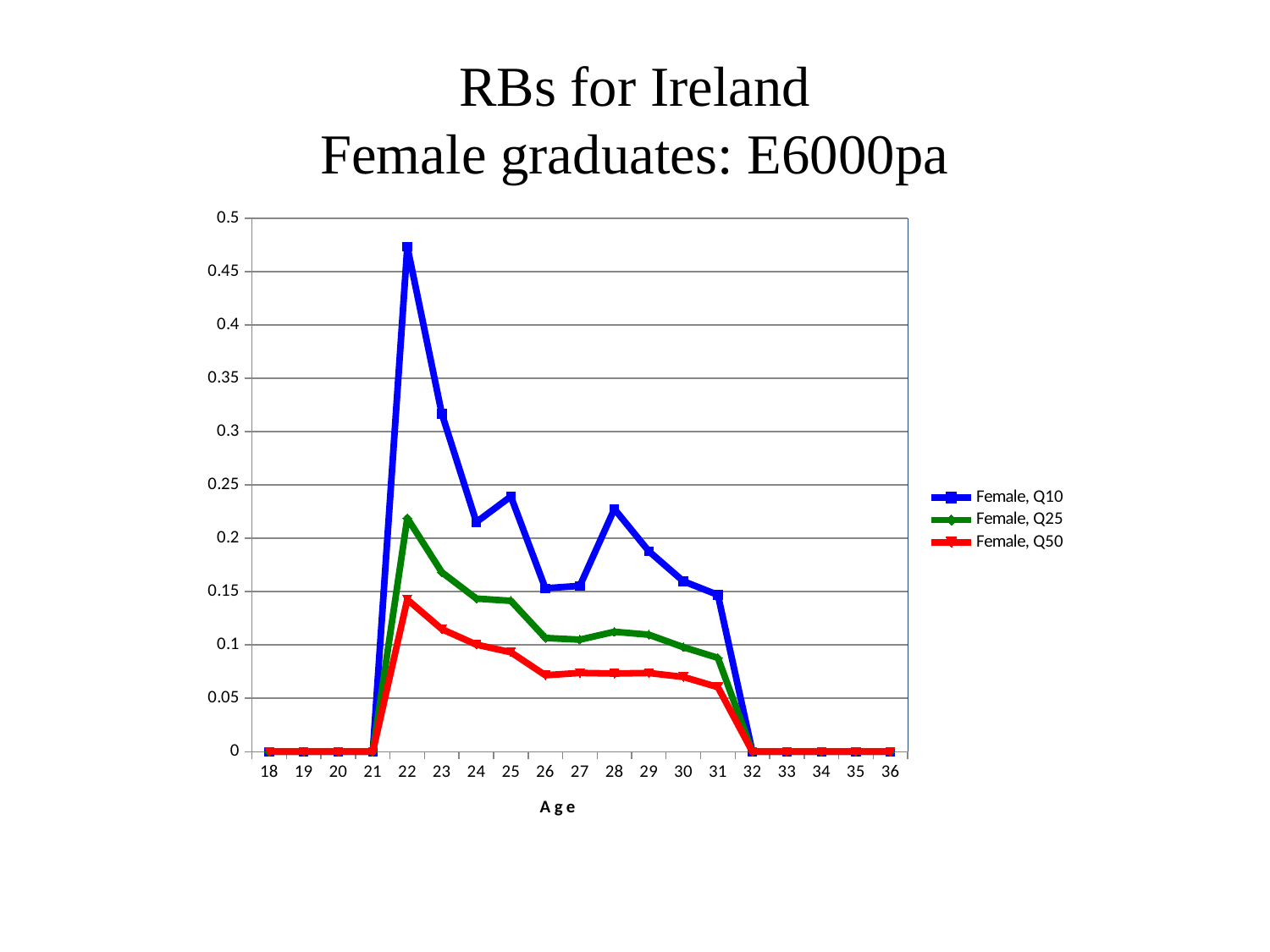
For Female, Q10, is the value at age 28 larger or smaller than the value at age 26? larger Is the value for Female, Q25 at age 22 greater or less than 0.2? greater How many series does the legend list? 3 Is the value for Female, Q10 at age 22 greater or less than 0.45? greater Is the value for Female, Q50 at age 22 greater or less than 0.1? greater What is the title of the x axis? Age What kind of chart is shown on the slide? line chart How many ages are plotted along the x axis? 19 At which age does the Female, Q10 series reach its highest value? 22 What is the value for Female, Q50 at age 34? 0 What is the value for Female, Q10 at age 18? 0 At age 25, which series has the larger value, Female, Q10 or Female, Q25? Female, Q10